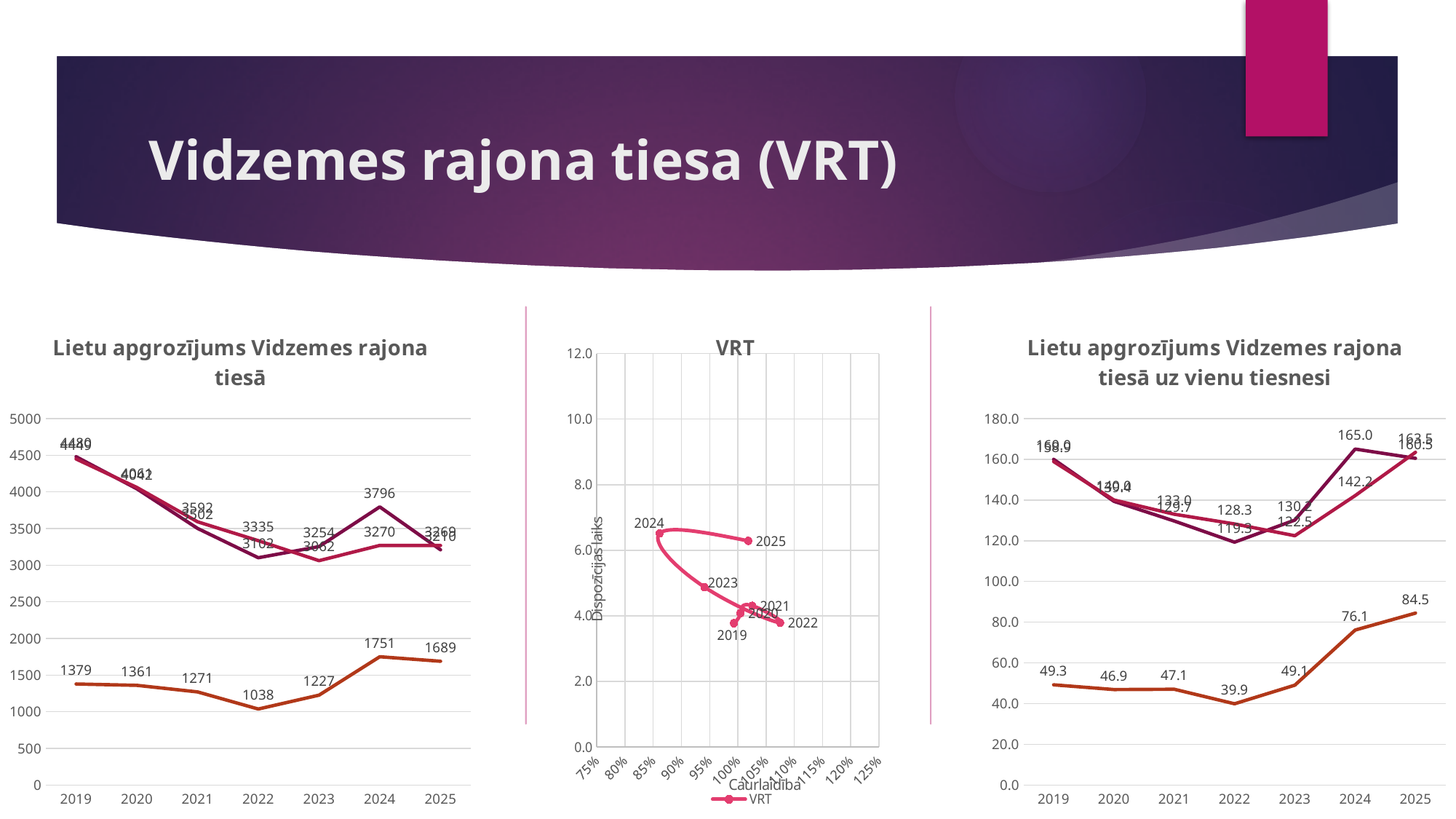
In the middle chart 'VRT', is the Dispozīcijas laiks value for 2023 greater or less than 6.0? less In the left chart 'Lietu apgrozījums Vidzemes rajona tiesā', what is the value of the orange (lowest) line in 2022? 1038 What is the x-axis title of the middle chart 'VRT'? Caurlaidība In the left chart 'Lietu apgrozījums Vidzemes rajona tiesā', in which year does the orange (lowest) line reach its highest value? 2024 How many years are shown on the x axis of the left chart 'Lietu apgrozījums Vidzemes rajona tiesā'? 7 In the right chart 'Lietu apgrozījums Vidzemes rajona tiesā uz vienu tiesnesi', what is the difference between the orange line's values in 2025 and 2024? 8.4 What kind of chart is the left chart 'Lietu apgrozījums Vidzemes rajona tiesā'? line chart In the left chart 'Lietu apgrozījums Vidzemes rajona tiesā', in which year does the orange (lowest) line reach its lowest value? 2022 In the left chart 'Lietu apgrozījums Vidzemes rajona tiesā', by how much does the orange line's value in 2024 exceed its value in 2025? 62 In the right chart 'Lietu apgrozījums Vidzemes rajona tiesā uz vienu tiesnesi', what is the value of the orange (lowest) line in 2025? 84.5 In the right chart 'Lietu apgrozījums Vidzemes rajona tiesā uz vienu tiesnesi', in which year is the orange (lowest) line at its minimum? 2022 How many series does the legend of the middle chart 'VRT' list? 1